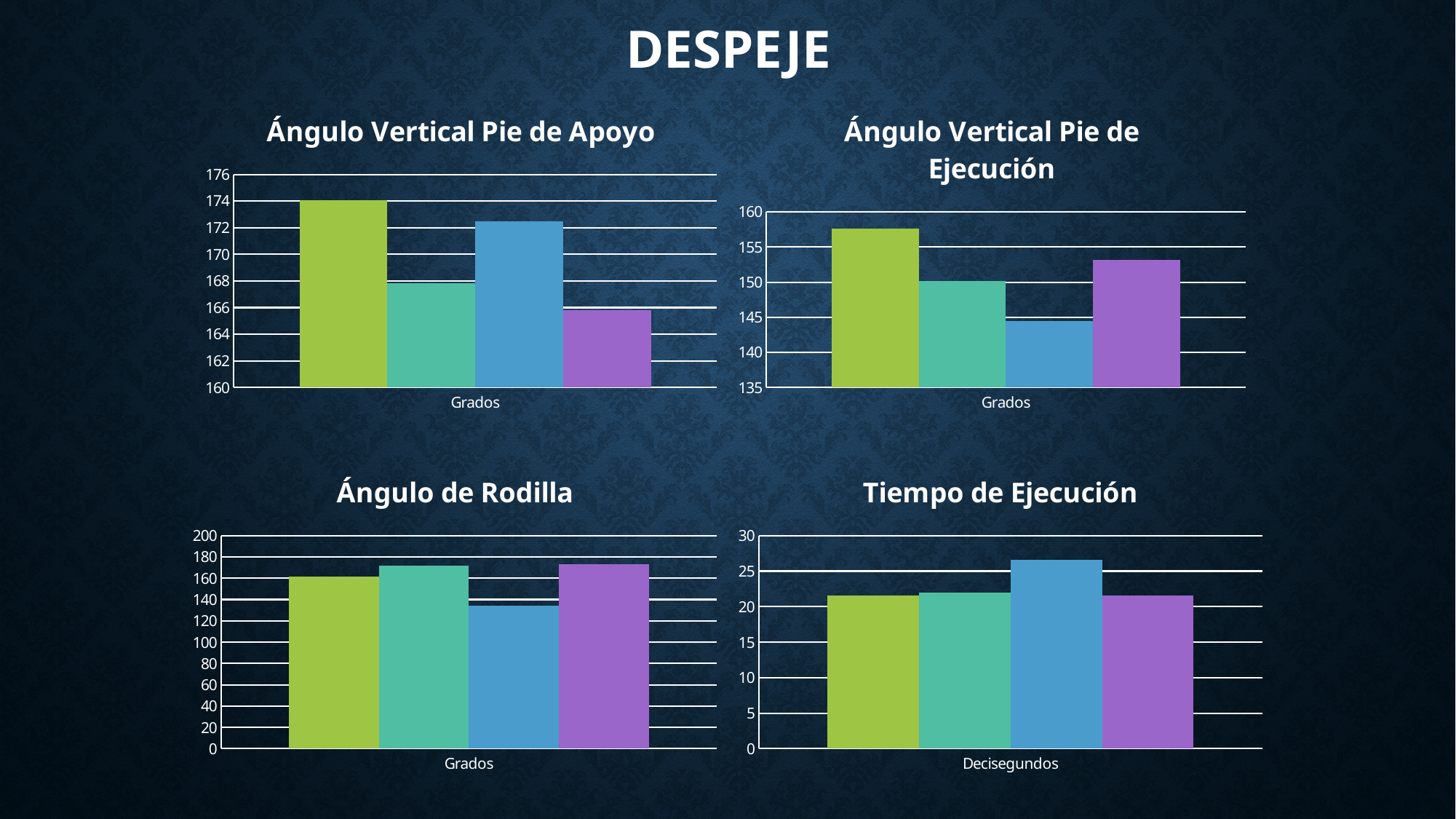
In the "Tiempo de Ejecución" chart, which bar is the tallest? the third (blue) bar In the "Ángulo Vertical Pie de Apoyo" chart, is the value of the first (green) bar greater or less than 172? greater In the "Ángulo Vertical Pie de Apoyo" chart, which bar is the tallest? the first (green) bar In the "Ángulo Vertical Pie de Apoyo" chart, which bar is the shortest? the fourth (purple) bar What is the x-axis label of the "Tiempo de Ejecución" chart? Decisegundos In the "Ángulo Vertical Pie de Ejecución" chart, is the value of the third (blue) bar greater or less than 150? less In the "Ángulo de Rodilla" chart, is the value of the third (blue) bar greater or less than 140? less In the "Ángulo Vertical Pie de Ejecución" chart, which bar is the tallest? the first (green) bar How many bars are plotted in the "Tiempo de Ejecución" chart? 4 What kind of chart is "Ángulo Vertical Pie de Apoyo"? bar chart In the "Ángulo de Rodilla" chart, which bar is the shortest? the third (blue) bar